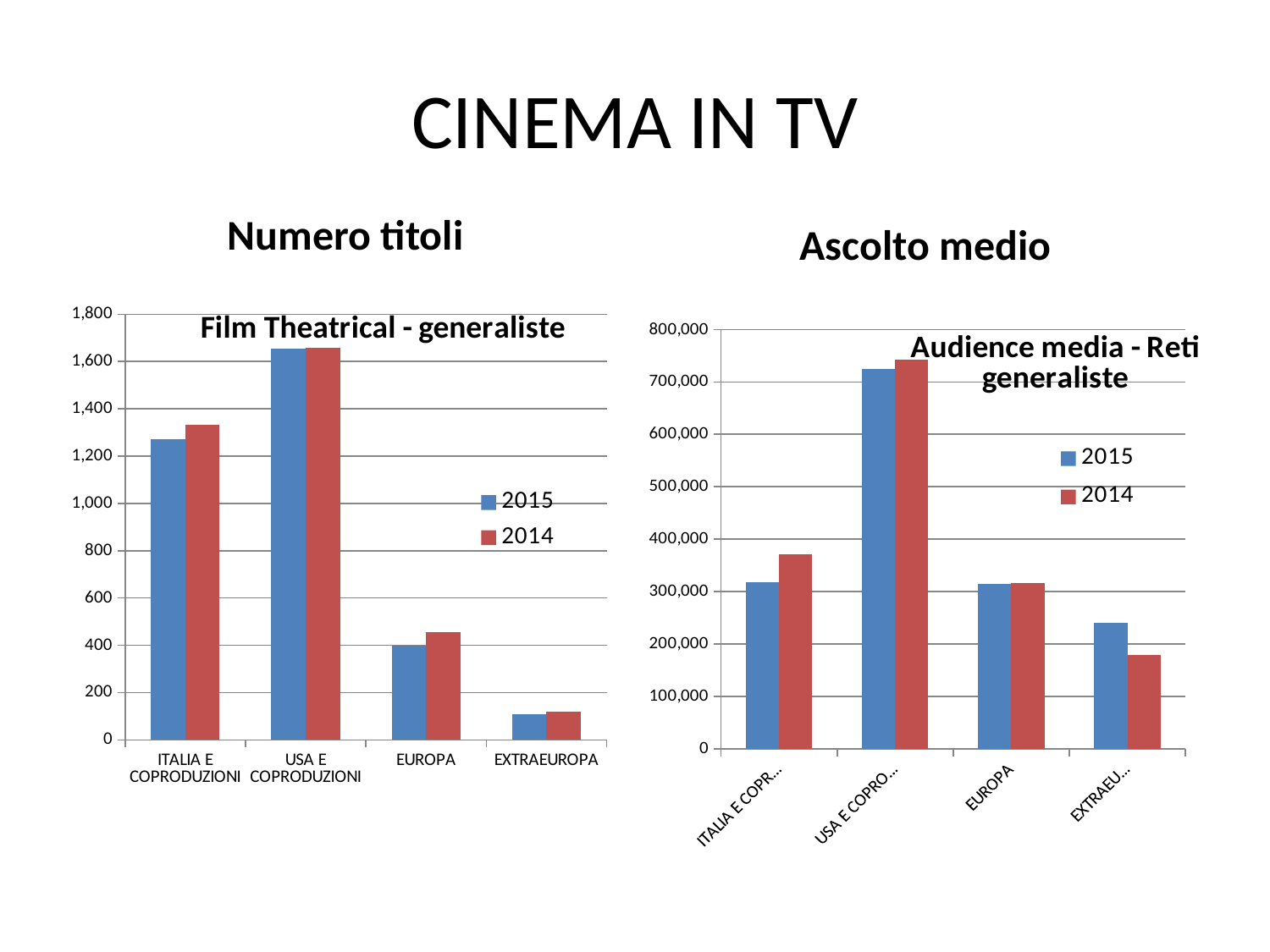
In the 'Film Theatrical - generaliste' chart, which category has the lowest value for 2014? EXTRAEUROPA What kind of chart is the 'Film Theatrical - generaliste' chart on the left? bar chart In the 'Film Theatrical - generaliste' chart, is the 2015 value for ITALIA E COPRODUZIONI greater or less than 1,200? greater In the 'Film Theatrical - generaliste' chart, is the 2014 value for EUROPA greater or less than 600? less In the 'Audience media - Reti generaliste' chart, which is larger for EXTRAEU...: the 2015 value or the 2014 value? 2015 In the 'Audience media - Reti generaliste' chart on the right, which category has the highest value for 2014? USA E COPRO... How many series does the legend of the 'Film Theatrical - generaliste' chart list? 2 What is the heading shown above the right-hand chart? Ascolto medio In the 'Audience media - Reti generaliste' chart, is the 2015 value for EUROPA greater or less than 400,000? less In the 'Film Theatrical - generaliste' chart, which category has the highest value for 2015? USA E COPRODUZIONI In the 'Film Theatrical - generaliste' chart, which is larger for EUROPA: the 2015 value or the 2014 value? 2014 How many categories are shown on the x axis of the 'Film Theatrical - generaliste' chart? 4